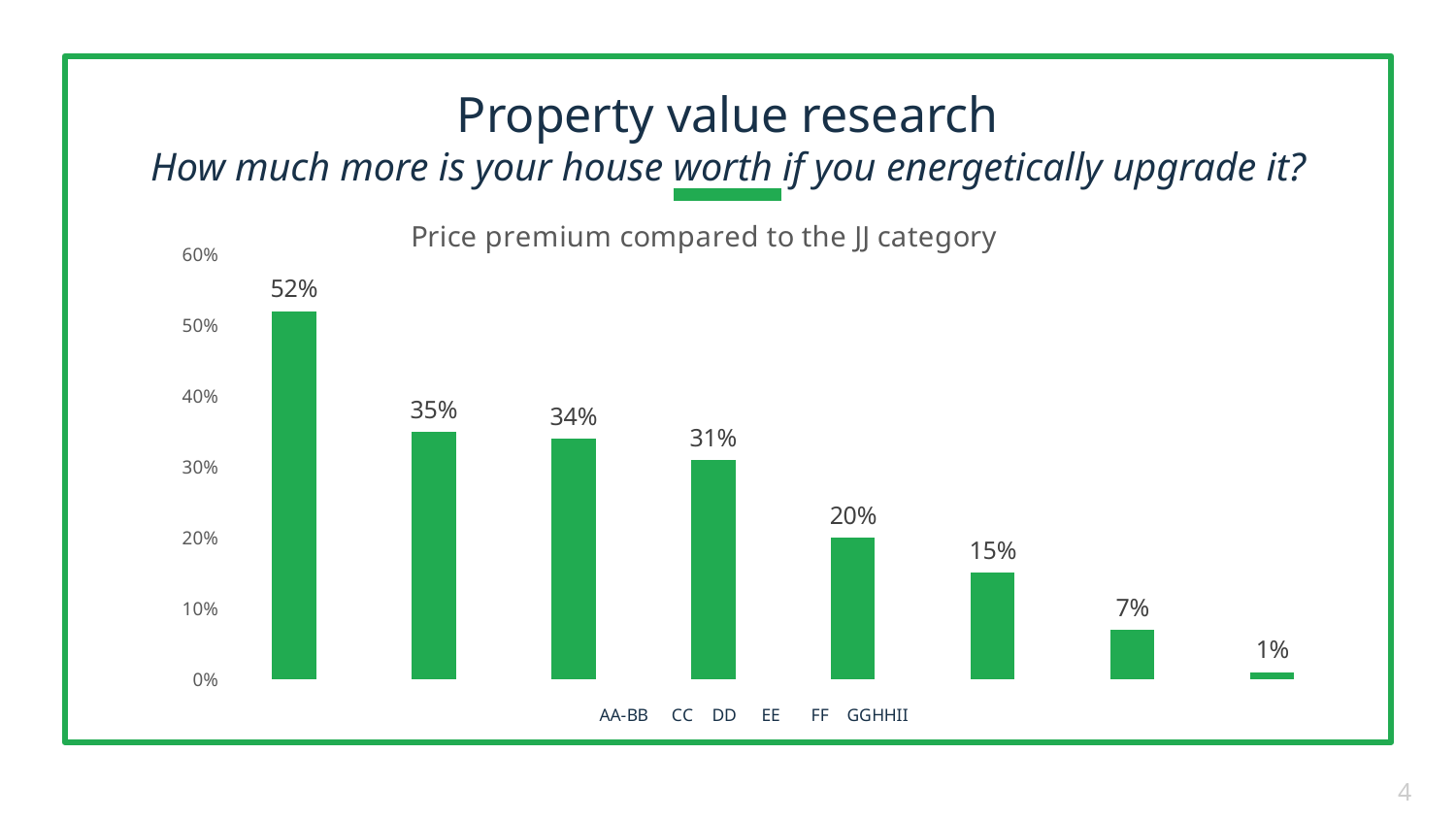
What is the lowest value shown in the chart? 1% What is the value of the second bar from the left? 35% Do the bar values rise or fall from left to right across the chart? fall What is the value of the rightmost bar? 1% Which is larger, the fifth bar from the left or the sixth bar from the left? the fifth bar (20%) How many bars are plotted in the chart? 8 What is the value of the fourth bar from the left? 31% What is the title of the chart? Price premium compared to the JJ category What is the highest value shown in the chart? 52% What is the difference between the tallest bar (52%) and the second tallest bar (35%)? 17% What type of chart is shown on the slide? bar chart What is the value of the leftmost (tallest) bar? 52%